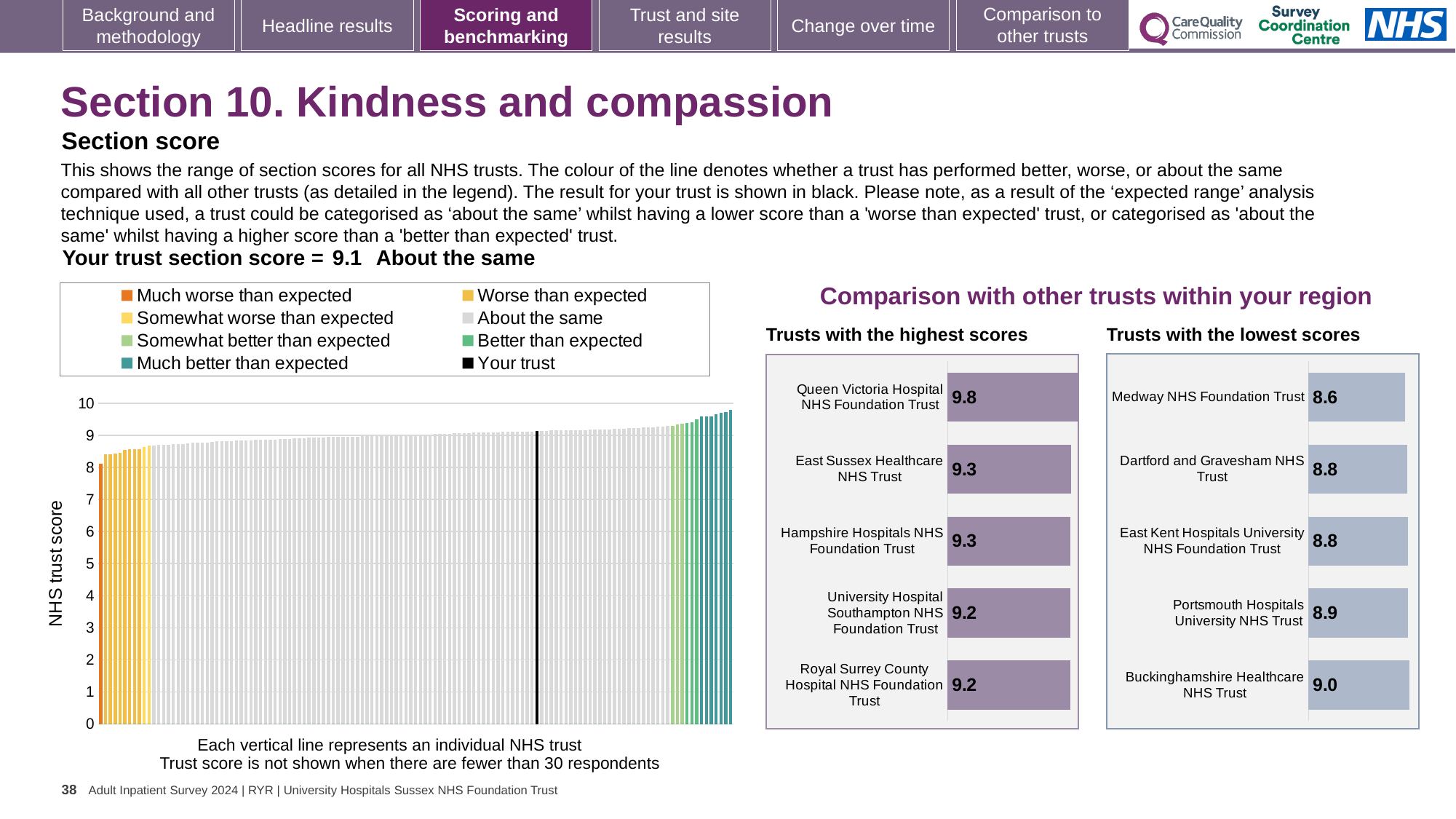
In the NHS trust score chart on the left, do the values rise or fall from left to right along the x axis? Rise In the 'Trusts with the highest scores' chart, what is the score for Queen Victoria Hospital NHS Foundation Trust? 9.8 In the 'Trusts with the lowest scores' chart, what is the score for Medway NHS Foundation Trust? 8.6 In the 'Trusts with the lowest scores' chart, which trust has the lowest score? Medway NHS Foundation Trust What kind of chart is the NHS trust score chart on the left of the slide? Bar chart In the 'Trusts with the highest scores' chart, how many trusts are listed? 5 In the 'Trusts with the highest scores' chart, which trust has the highest score? Queen Victoria Hospital NHS Foundation Trust In the 'Trusts with the lowest scores' chart, what is the difference between the scores of Buckinghamshire Healthcare NHS Trust and Medway NHS Foundation Trust? 0.4 In the 'Trusts with the lowest scores' chart, what is the score for East Kent Hospitals University NHS Foundation Trust? 8.8 In the 'Trusts with the highest scores' chart, what is the difference between the scores of Queen Victoria Hospital NHS Foundation Trust and Royal Surrey County Hospital NHS Foundation Trust? 0.6 In the 'Trusts with the lowest scores' chart, which has the larger score: Portsmouth Hospitals University NHS Trust or Medway NHS Foundation Trust? Portsmouth Hospitals University NHS Trust How many entries does the legend of the NHS trust score chart on the left list? 8